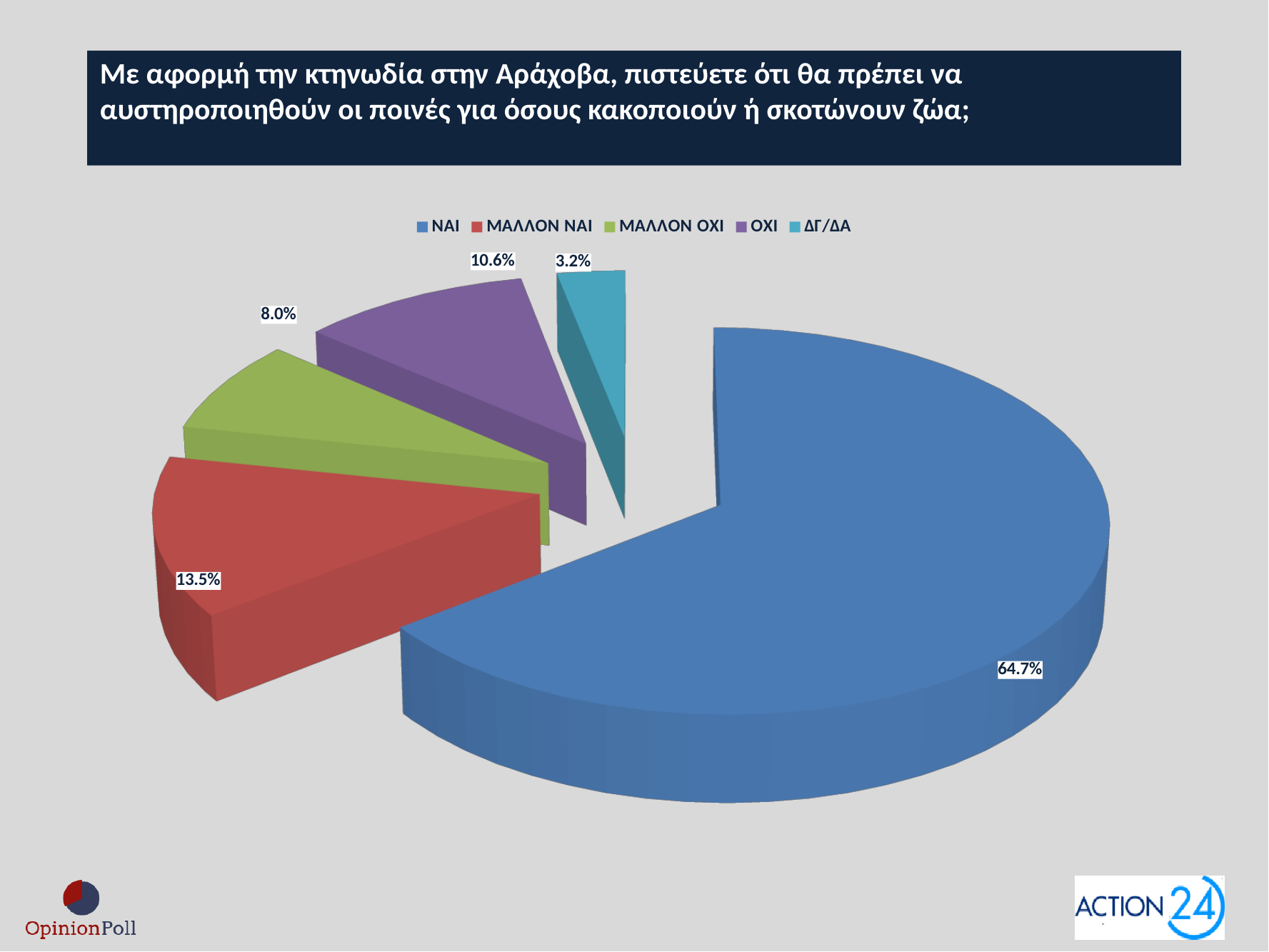
What colour is the slice representing ΝΑΙ? Blue What percentage of respondents answered ΜΑΛΛΟΝ ΝΑΙ? 13.5% Which is larger, the share for ΟΧΙ or the share for ΜΑΛΛΟΝ ΟΧΙ? ΟΧΙ What percentage of respondents answered ΔΓ/ΔΑ? 3.2% What is the difference in percentage points between ΝΑΙ and ΜΑΛΛΟΝ ΝΑΙ? 51.2 What percentage of respondents answered ΝΑΙ? 64.7% Which response has the largest share of the pie? ΝΑΙ Which response has the smallest share of the pie? ΔΓ/ΔΑ What percentage of respondents answered ΟΧΙ? 10.6% What percentage of respondents answered ΜΑΛΛΟΝ ΟΧΙ? 8.0% What type of chart is shown on the slide? Pie chart How many response categories are shown in the pie chart? 5